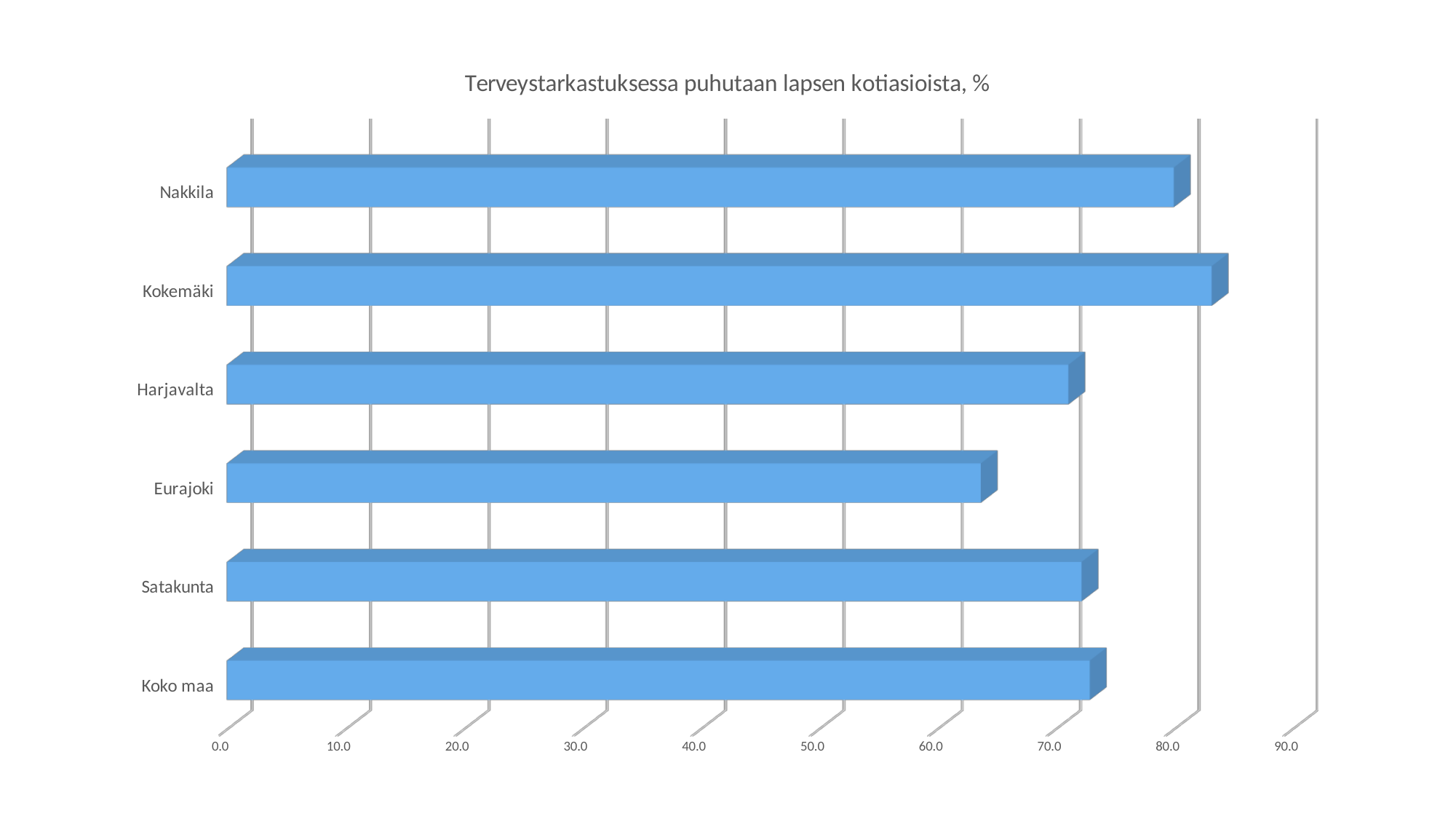
Is the value for Kokemäki greater or less than 80.0? greater How many categories are plotted in the chart? 6 What is the title of the chart? Terveystarkastuksessa puhutaan lapsen kotiasioista, % Is the value for Satakunta greater or less than 80.0? less What kind of chart is shown on the slide? bar chart Which has a larger value, Eurajoki or Kokemäki? Kokemäki Is the value for Eurajoki greater or less than 70.0? less Which category has the highest value? Kokemäki Which category has the lowest value? Eurajoki Which has a larger value, Nakkila or Harjavalta? Nakkila